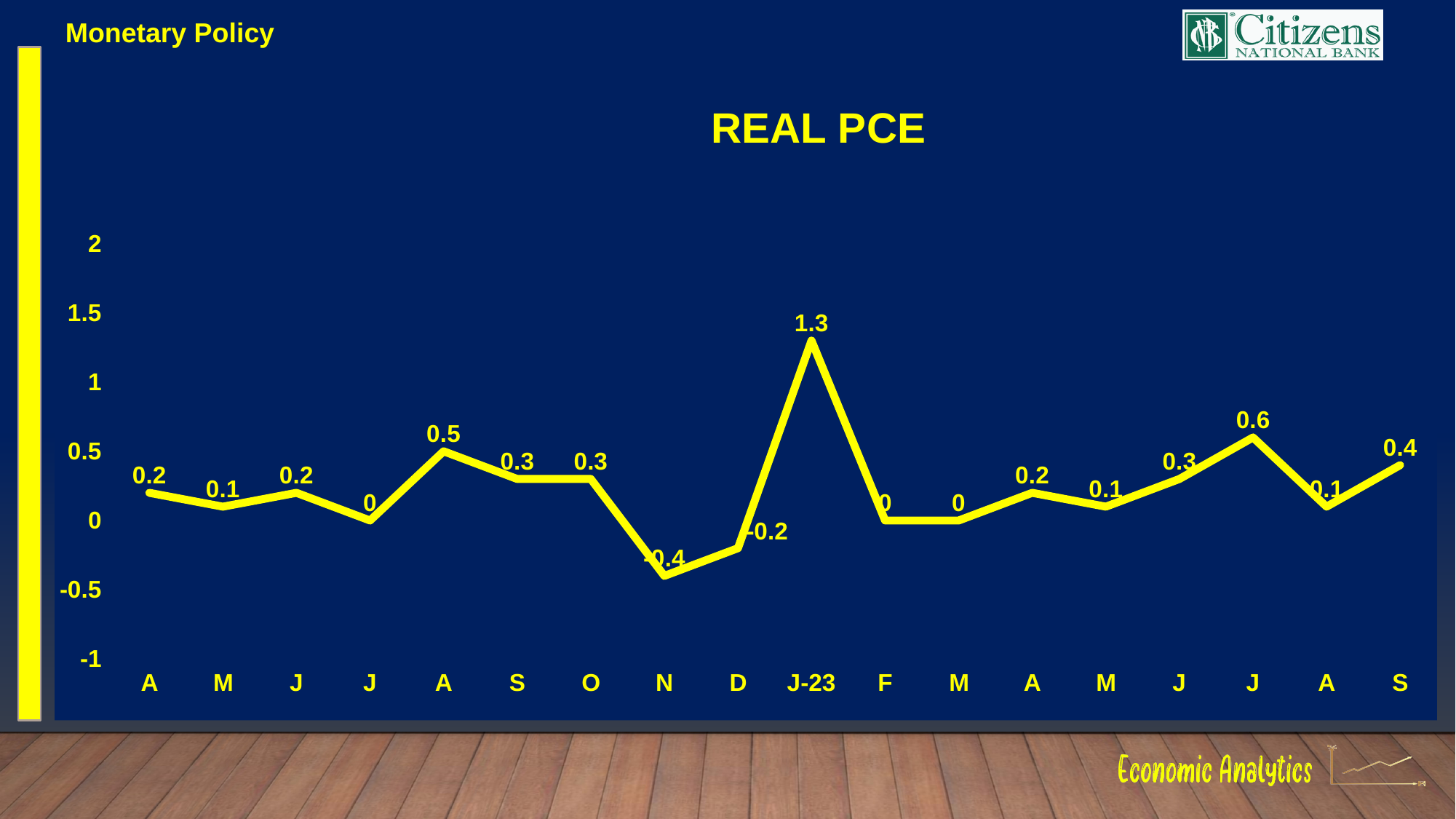
What is the value for D? -0.2 Which month has the highest value? J-23 What is the value for F? 0 Which is larger, the value for O or the value for D? O What is the difference between the values for J-23 and F? 1.3 What is the value for J-23? 1.3 How many data points are plotted on the chart? 18 What is the title of the chart? REAL PCE Which month has the lowest value? N What is the value for N? -0.4 What type of chart is shown on the slide? line chart What is the value for the last point, S, at the right end of the chart? 0.4